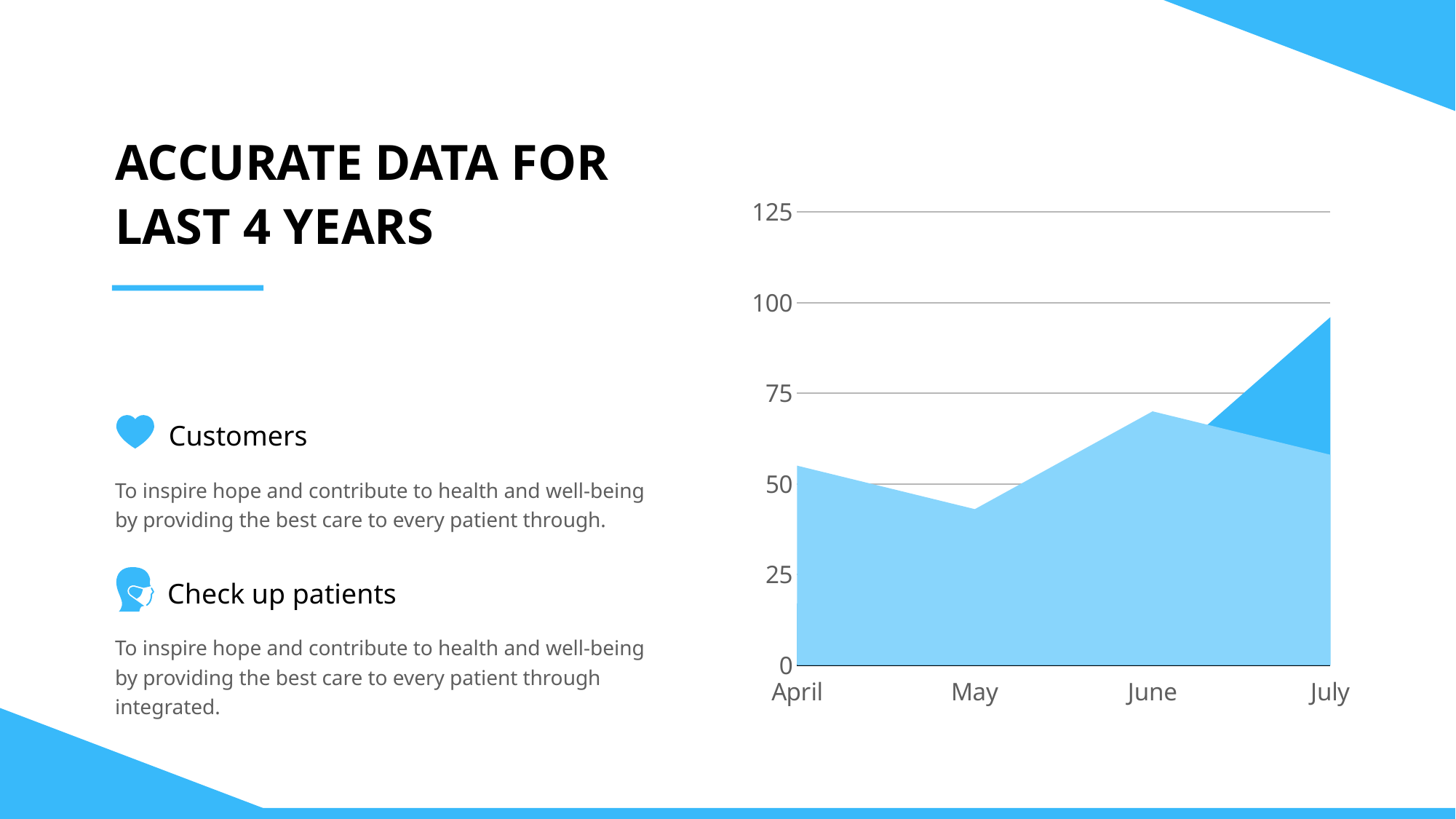
Does the lighter blue area rise or fall from April to May? Fall Which month is the first category on the x axis of the chart? April For the lighter blue area, which month has the larger value, May or June? June How many months are shown along the x axis of the chart? 4 Is the value of the darker blue area for July greater or less than 100? less What kind of chart is shown on the slide? Area chart Is the value of the lighter blue area for May greater or less than 50? less In which month does the lighter blue area reach its lowest value? May What is the highest value labelled on the vertical axis of the chart? 125 Is the value of the darker blue area for July greater or less than 75? greater In which month does the lighter blue area reach its highest value? June